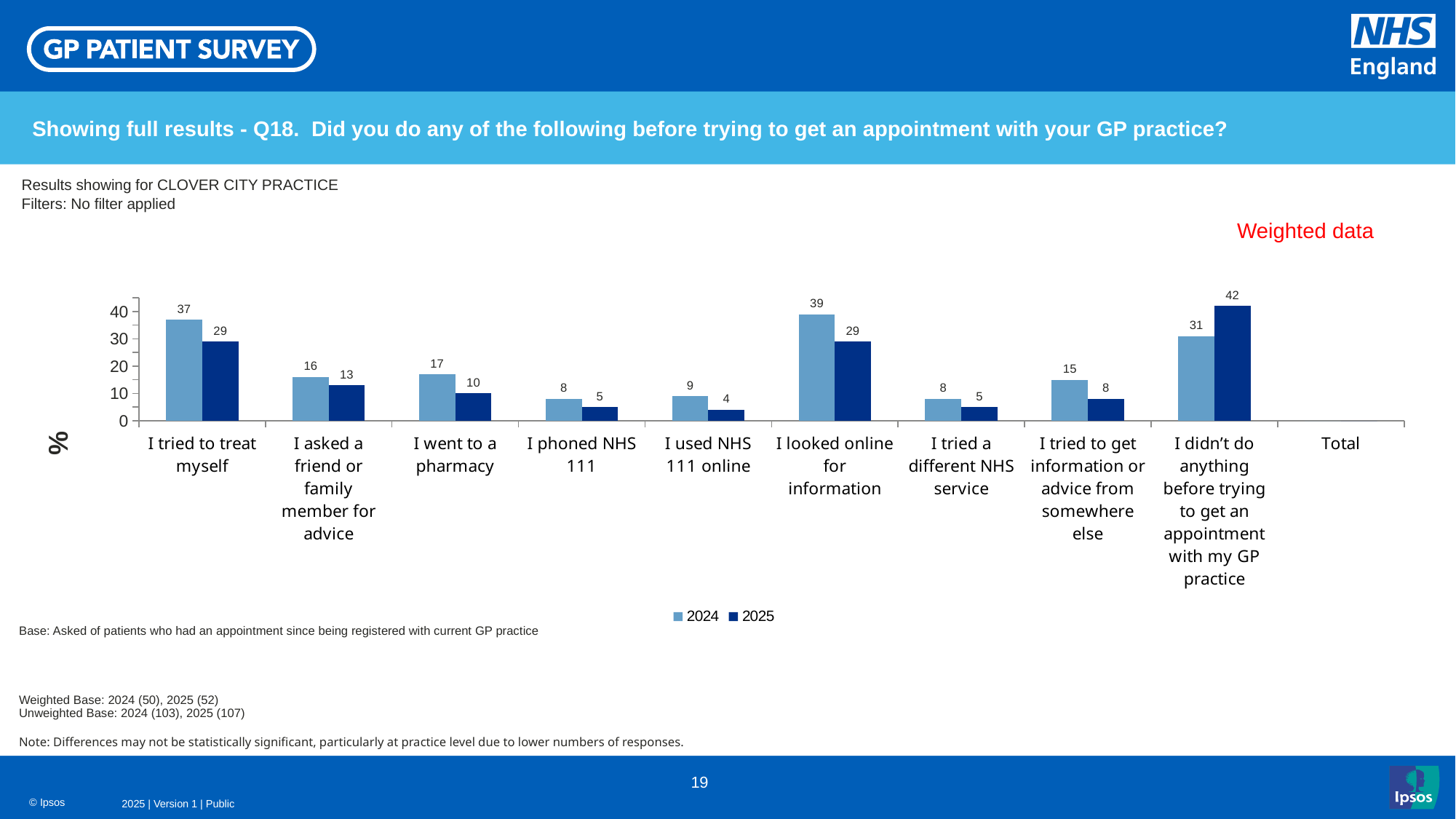
What kind of chart is shown on the slide? Bar chart Which is larger: the 2024 value for "I phoned NHS 111" or the 2024 value for "I used NHS 111 online"? I used NHS 111 online What is the difference between the 2024 and 2025 values for "I tried to treat myself"? 8 What is the 2025 value for "I went to a pharmacy"? 10 What is the 2024 value for "I tried to get information or advice from somewhere else"? 15 Which category has the highest 2025 value? I didn't do anything before trying to get an appointment with my GP practice Which category has the lowest 2025 value? I used NHS 111 online What is the 2025 value for "I didn't do anything before trying to get an appointment with my GP practice"? 42 What is the difference between the 2025 and 2024 values for "I didn't do anything before trying to get an appointment with my GP practice"? 11 Is the 2024 value for "I looked online for information" greater or less than 30? greater How many series does the legend list? 2 What is the 2024 value for "I looked online for information"? 39